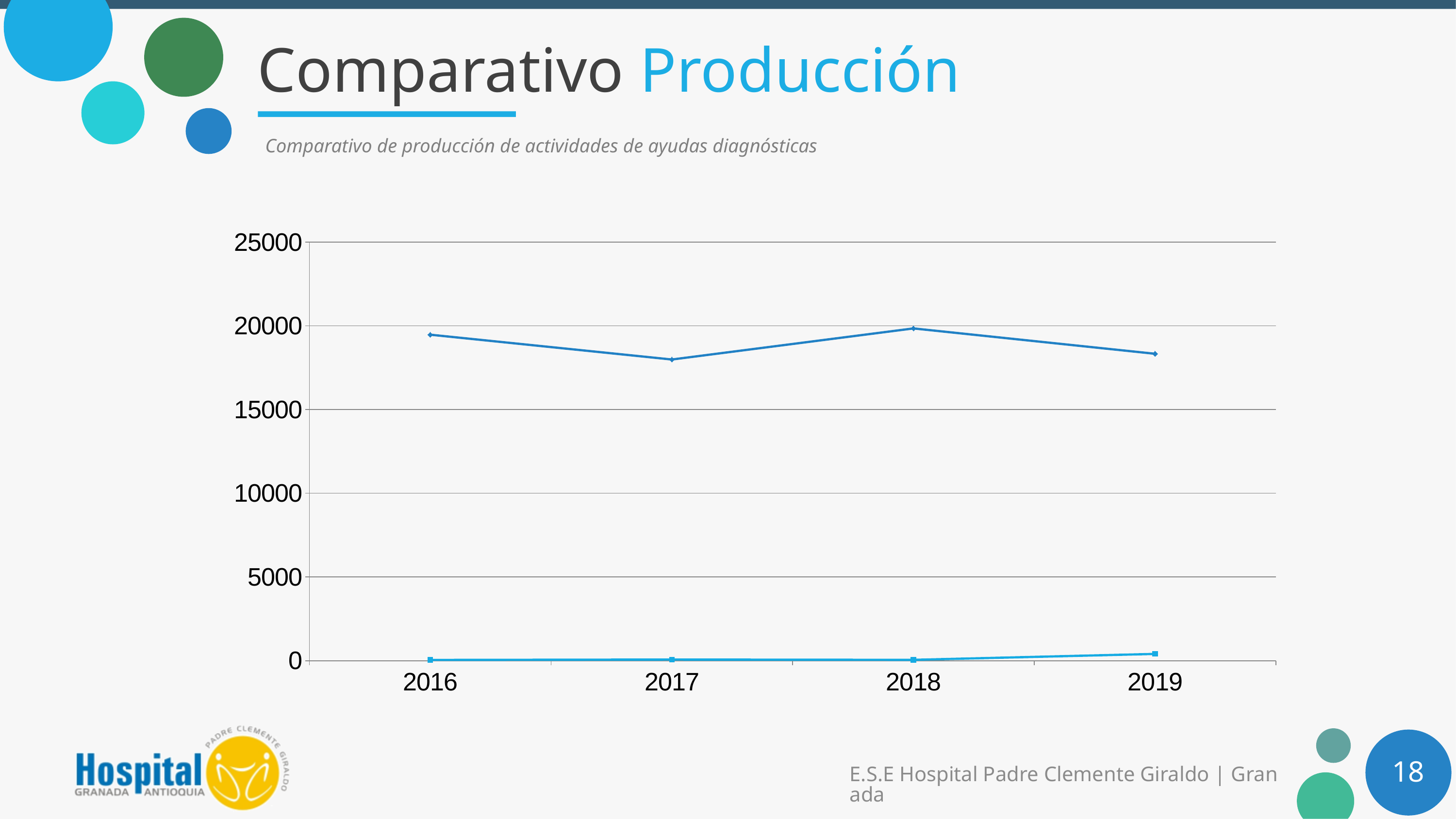
How many lines are plotted on the chart? 2 For the upper line, which year has the larger value, 2017 or 2018? 2018 Is the value of the upper line for 2016 greater or less than 15000? greater For the upper line, which year has the larger value, 2016 or 2017? 2016 Does the upper line rise or fall from 2018 to 2019? fall Is the value of the upper line for 2017 greater or less than 20000? less How many years are plotted along the x axis? 4 Is the value of the lower line for 2019 greater or less than 5000? less What kind of chart is shown on the slide? line chart What is the title of the slide containing the chart? Comparativo Producción In which year does the upper line reach its highest value? 2018